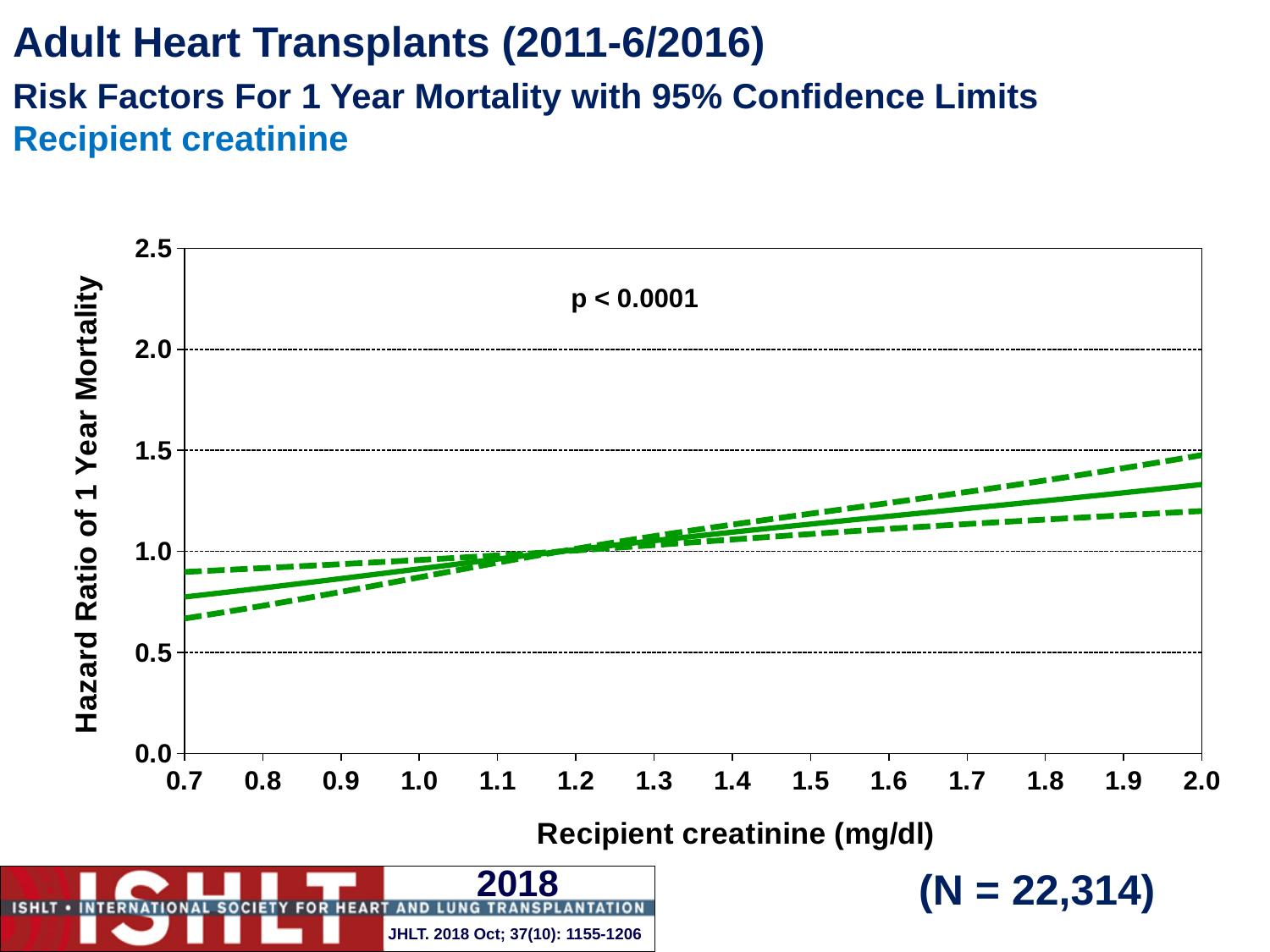
What kind of chart is shown on the slide? Line chart Is the hazard ratio (solid line) at a recipient creatinine of 0.7 mg/dl greater or less than 1.0? less Is the upper 95% confidence limit at a recipient creatinine of 0.7 mg/dl greater or less than 1.0? less Is the hazard ratio (solid line) at a recipient creatinine of 2.0 mg/dl greater or less than 1.0? greater What p-value is printed on the chart? p < 0.0001 How many tick marks are labelled on the x axis? 14 Does the hazard ratio of 1 year mortality rise or fall as recipient creatinine increases along the x axis? Rise What is the highest value labelled on the y axis? 2.5